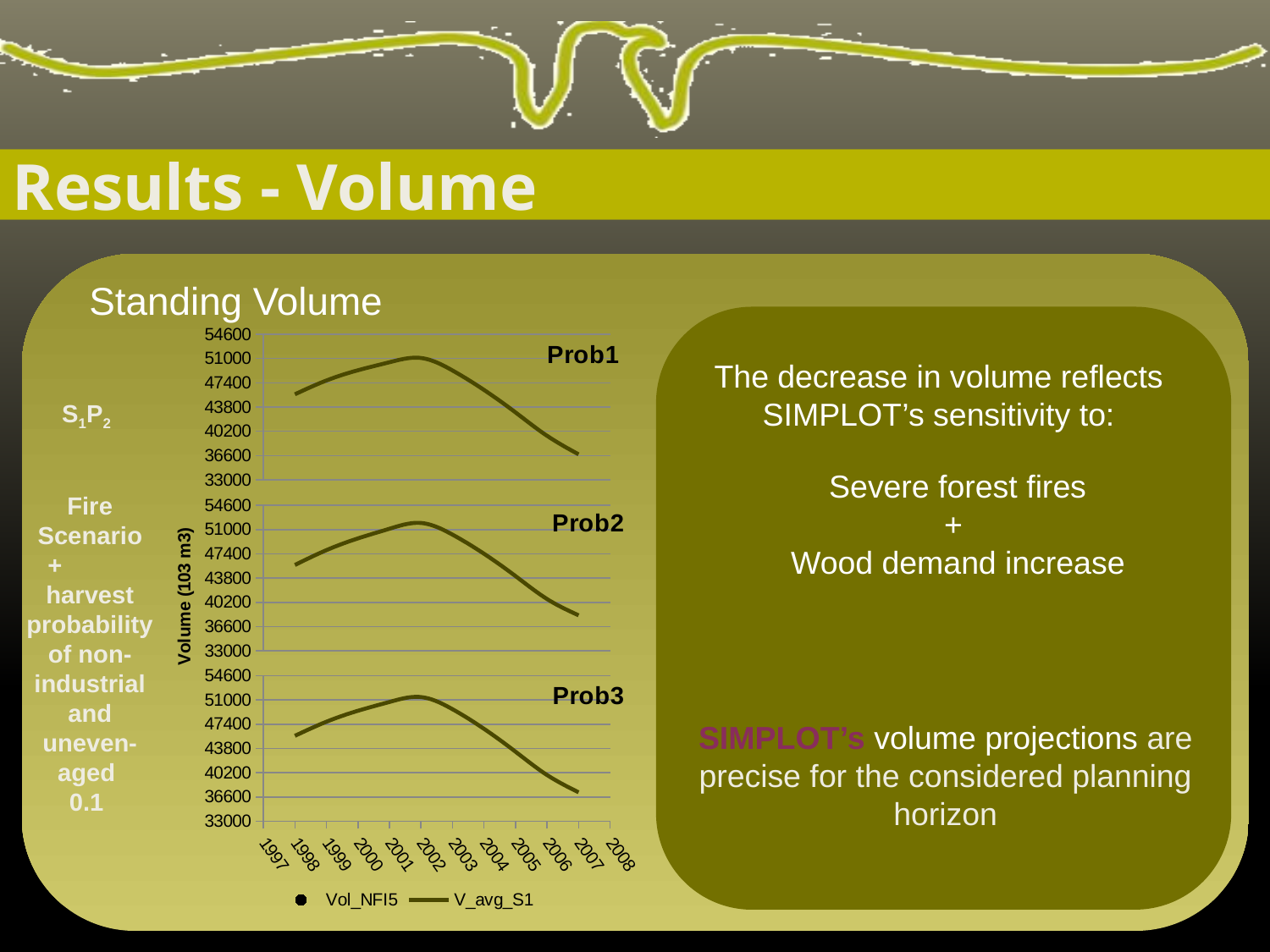
In the Prob1 panel, is the value for 2007 greater or less than 40200? less In the Prob3 panel, is the value for 2007 greater or less than 40200? less What kind of chart is used for the Prob1 panel of the Standing Volume chart? line chart What is the y-axis title of the Standing Volume chart? Volume (103 m3) In the Prob3 panel, is the value for 2002 greater or less than 47400? greater How many series does the legend of the Standing Volume chart list? 2 How many years are labelled on the x axis of the Standing Volume chart? 12 In the Prob2 panel, does the line rise or fall between 2002 and 2007? fall In the Prob1 panel, does the line rise or fall between 1998 and 2002? rise What are the two legend entries of the Standing Volume chart? Vol_NFI5 and V_avg_S1